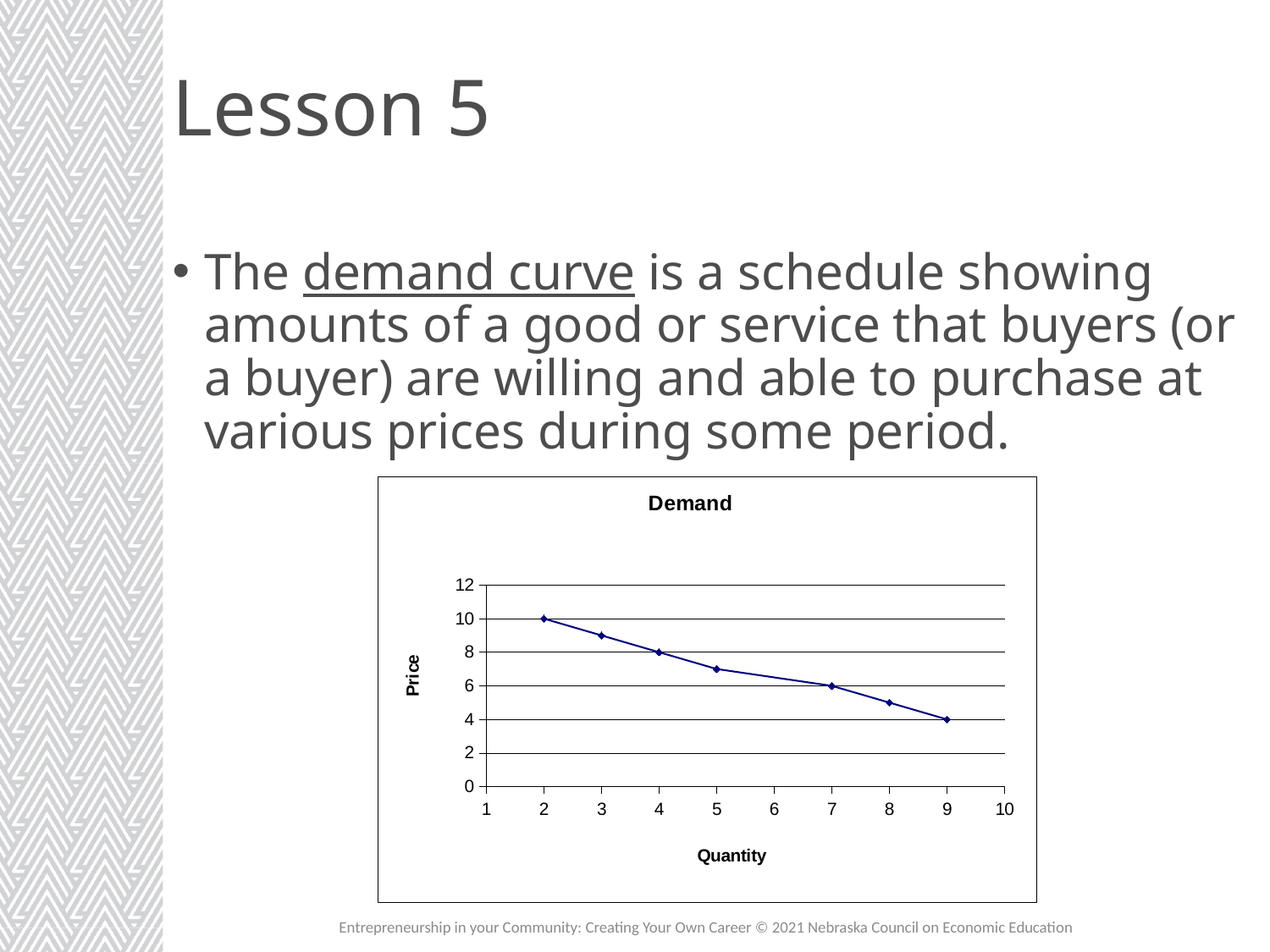
What is the title of the chart? Demand What is the label of the y axis? Price What is the price at a quantity of 9? 4 What kind of chart is shown on the slide? line chart What is the price at a quantity of 7? 6 Is the price at a quantity of 3 greater or less than 8? greater At which quantity is the price highest? 2 What is the difference between the price at quantity 2 and the price at quantity 9? 6 At which quantity is the price lowest? 9 What is the price at a quantity of 2? 10 Do prices rise or fall as quantity increases along the x axis? fall What is the price at a quantity of 4? 8